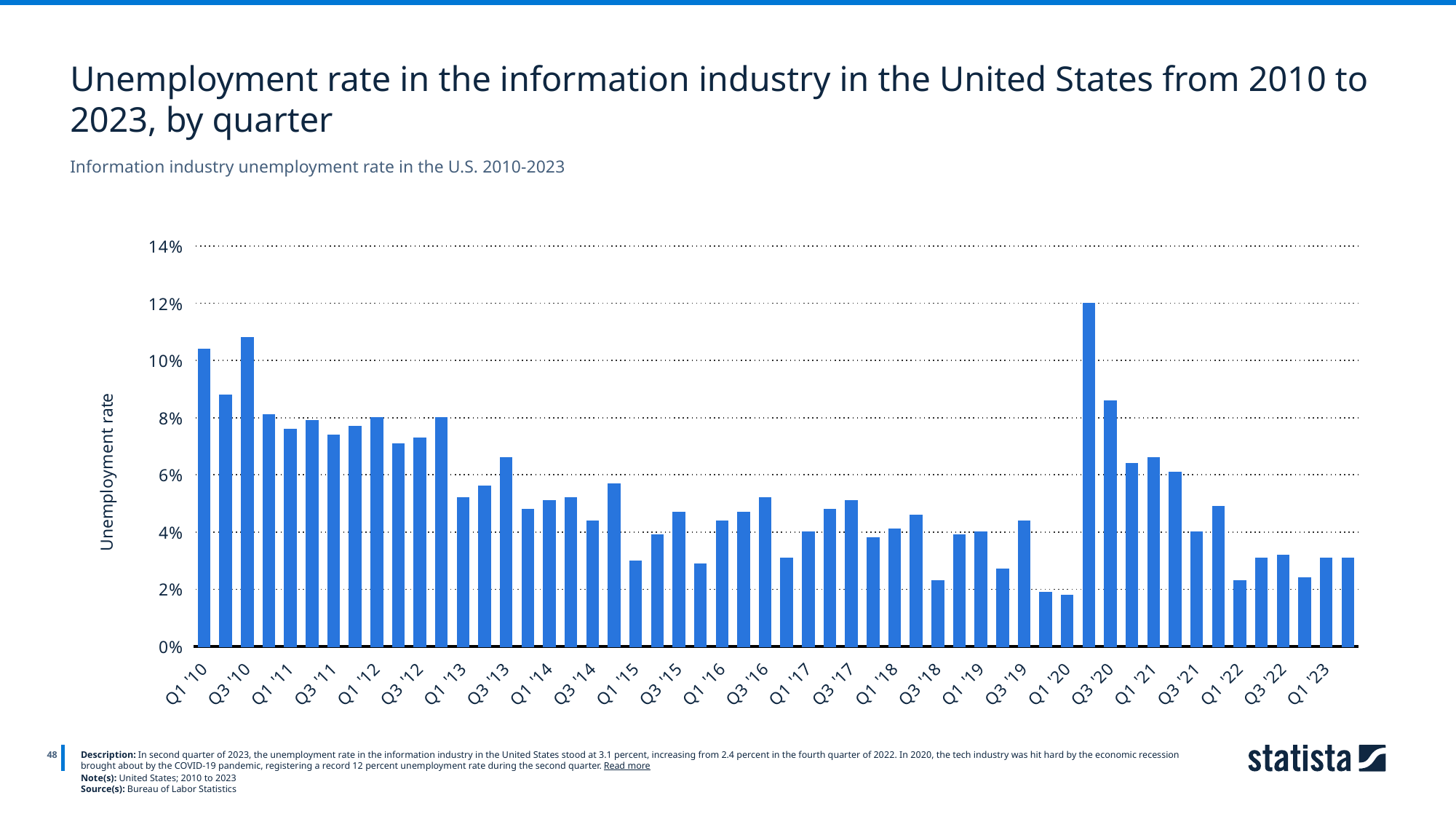
Do the values generally rise or fall from Q1 '10 to Q3 '19? fall Which is larger, the value for Q1 '13 or the value for Q3 '13? Q3 '13 Is the value for Q1 '10 greater or less than 10%? greater What is the record unemployment rate reached in 2020, where the tallest bar lands on the axis gridline? 12% In which year does the tallest bar in the chart occur? 2020 Is the value for Q1 '15 greater or less than 4%? less Is the value for Q1 '23 greater or less than 4%? less What is the source of the data shown in the chart? Bureau of Labor Statistics What kind of chart is shown on the slide? bar chart Which is larger, the value for Q1 '10 or the value for Q1 '23? Q1 '10 What is the title of the y axis? Unemployment rate